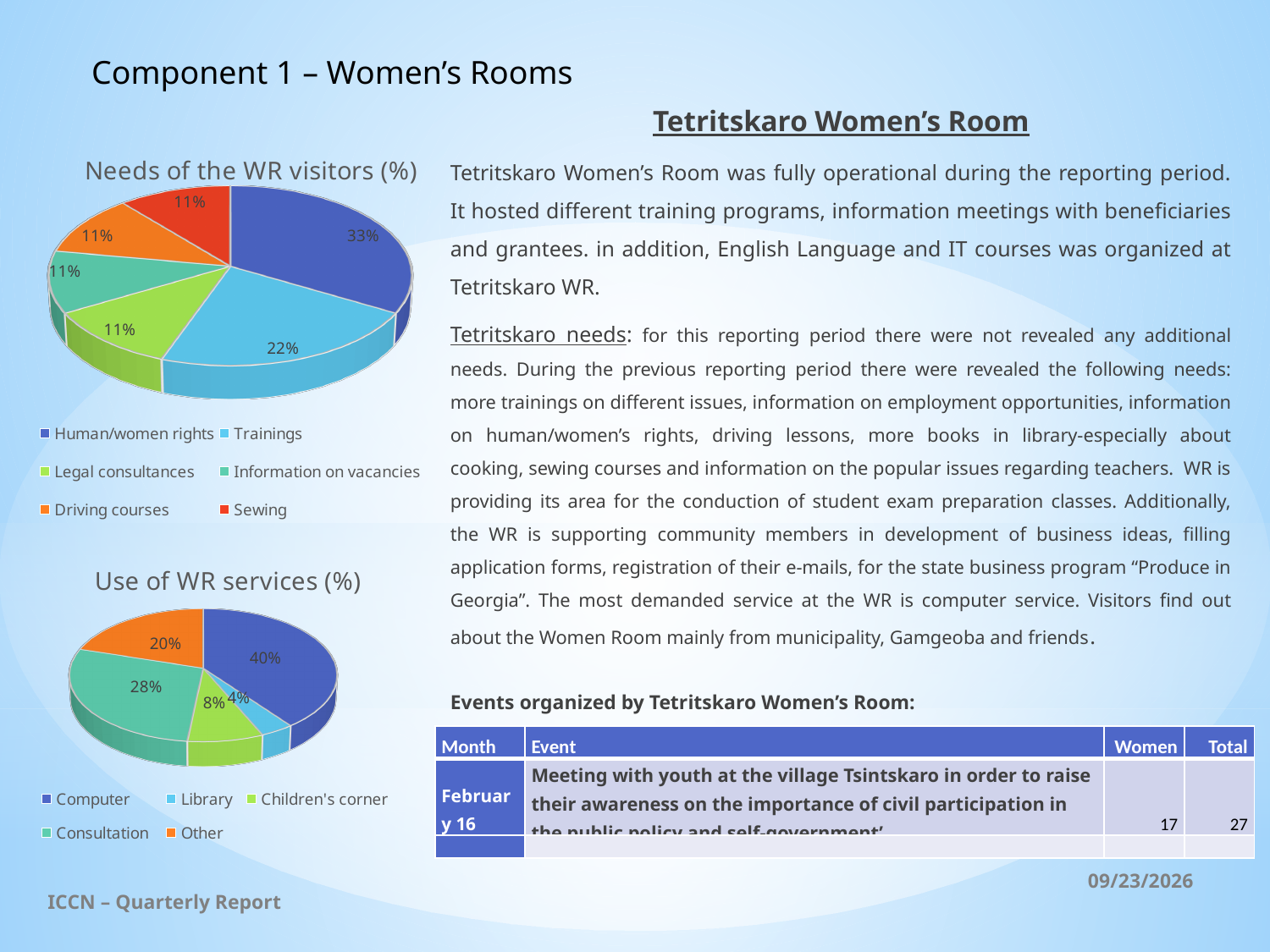
What type of chart is 'Use of WR services (%)'? Pie chart In the 'Needs of the WR visitors (%)' chart, what percentage is shown for Trainings? 22% In the 'Use of WR services (%)' chart, what percentage is shown for Consultation? 28% In the 'Use of WR services (%)' chart, how many categories does the legend list? 5 In the 'Needs of the WR visitors (%)' chart, what percentage is shown for Human/women rights? 33% In the 'Needs of the WR visitors (%)' chart, how many categories does the legend list? 6 In the 'Use of WR services (%)' chart, what percentage is shown for Computer? 40% In the 'Needs of the WR visitors (%)' chart, what is the difference between the Human/women rights share and the Trainings share? 11% In the 'Needs of the WR visitors (%)' chart, which category has the largest share? Human/women rights In the 'Use of WR services (%)' chart, which category has the smallest share? Library In the 'Use of WR services (%)' chart, what percentage is shown for Other? 20% In the 'Use of WR services (%)' chart, which is larger: Consultation or Other? Consultation